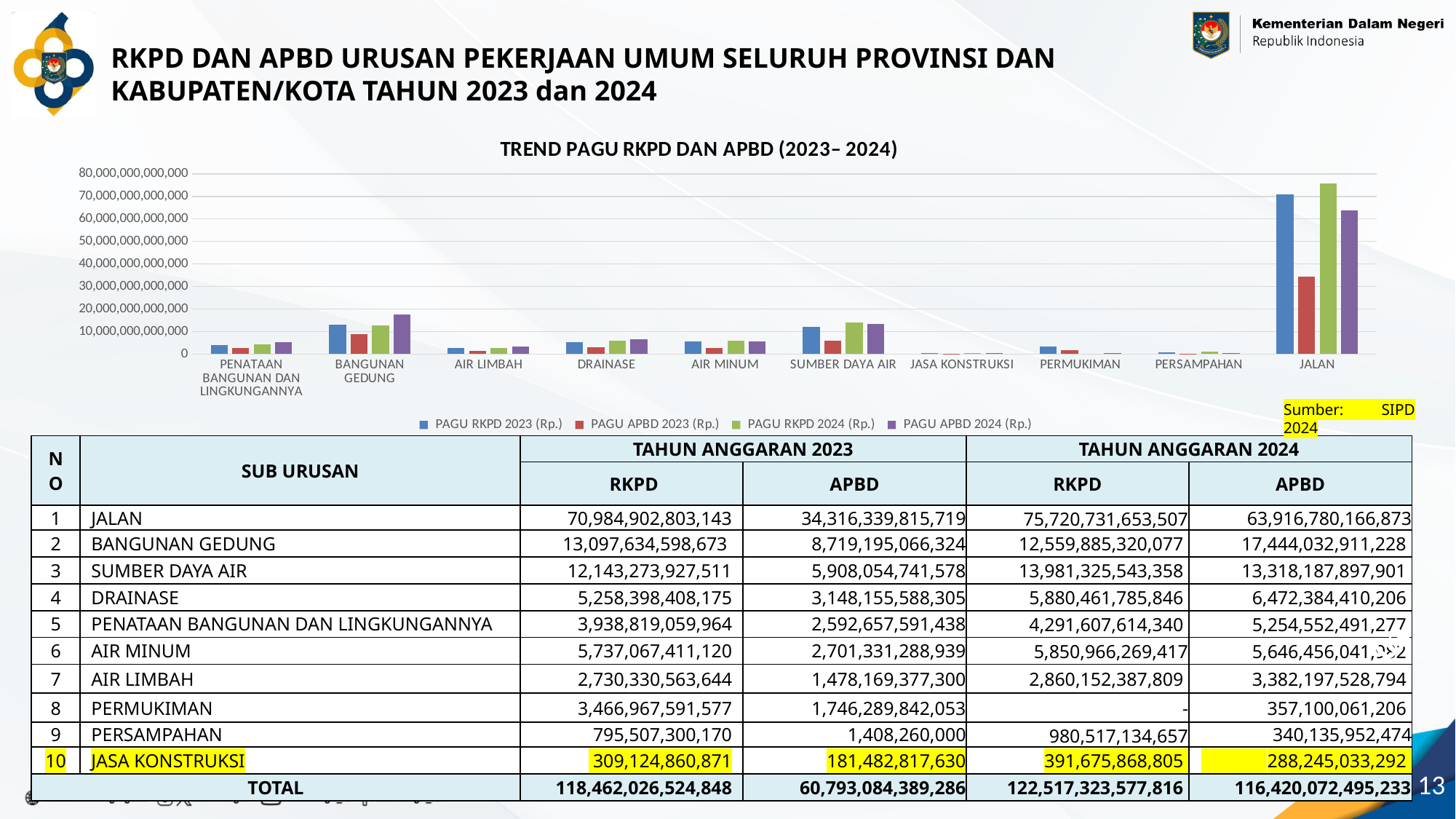
Is the PAGU APBD 2023 (Rp.) value for JALAN greater or less than 40,000,000,000,000? less For DRAINASE, which is larger: PAGU RKPD 2023 (Rp.) or PAGU APBD 2023 (Rp.)? PAGU RKPD 2023 (Rp.) Which category has the highest PAGU RKPD 2024 (Rp.) value in the chart? JALAN Using the values printed in the table, what is the difference between the RKPD 2024 and APBD 2024 values for JALAN? 11,803,951,486,634 What is the title of the chart? TREND PAGU RKPD DAN APBD (2023– 2024) Is the PAGU RKPD 2023 (Rp.) value for JALAN greater or less than 60,000,000,000,000? greater Is the PAGU APBD 2024 (Rp.) value for BANGUNAN GEDUNG greater or less than 10,000,000,000,000? greater How many sub-urusan categories are shown on the x axis of the chart? 10 What kind of chart is shown on the slide? bar chart For BANGUNAN GEDUNG, which is larger: PAGU RKPD 2024 (Rp.) or PAGU APBD 2024 (Rp.)? PAGU APBD 2024 (Rp.) What is the RKPD 2023 value for JALAN as printed in the table on the slide? 70,984,902,803,143 How many series does the legend of the chart list? 4